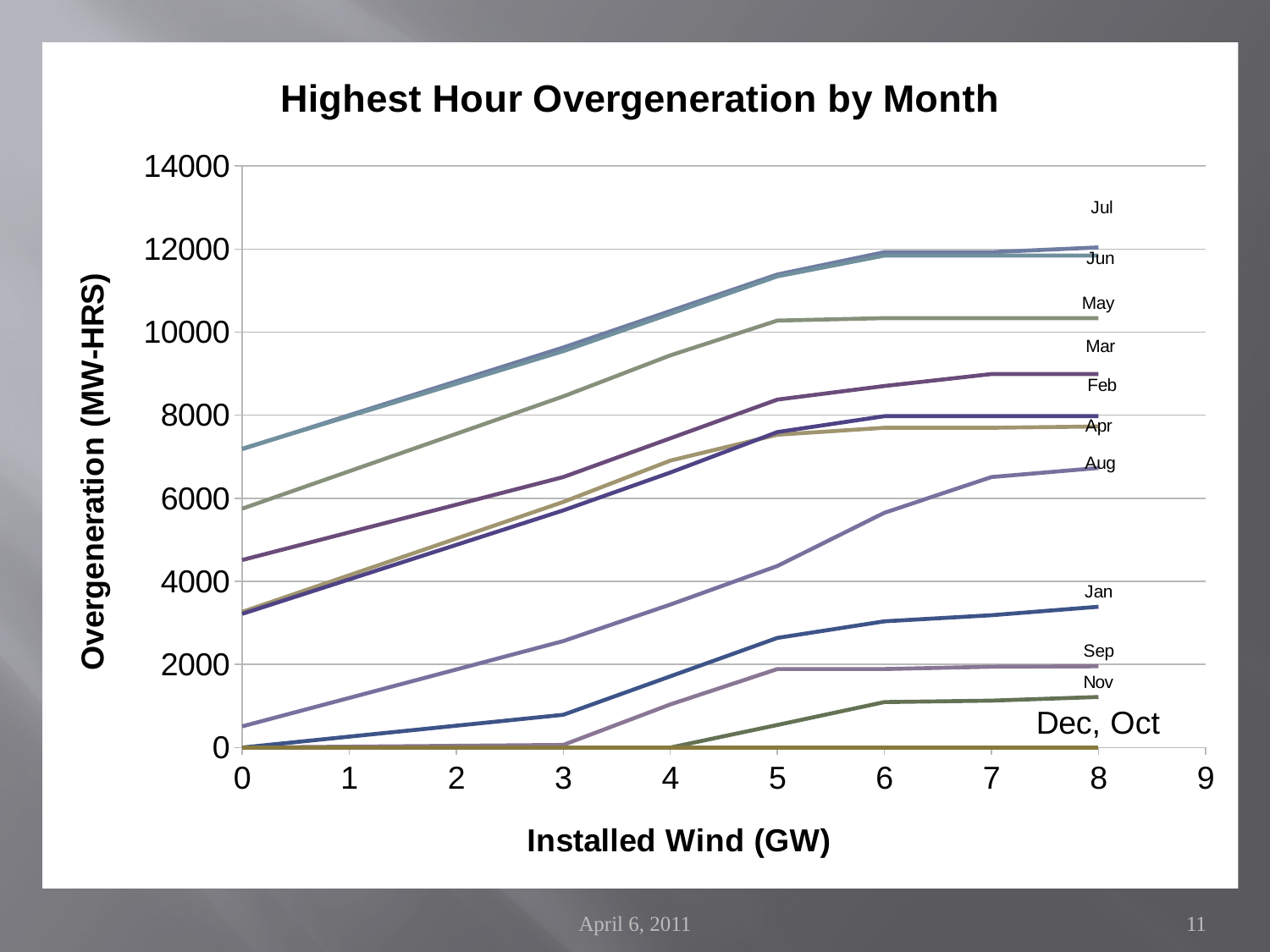
Is the value for Aug at 0 GW installed wind greater or less than 2000? less Is the value for May at 8 GW installed wind greater or less than 10000? greater Does the Jan line rise or fall as installed wind increases? rises What is the title of the chart? Highest Hour Overgeneration by Month What is the label of the x axis? Installed Wind (GW) Is the value for Mar at 8 GW installed wind greater or less than 8000? greater At 8 GW installed wind, which is larger, the value for May or the value for Mar? May How many month series are labelled on the chart? 12 Which months have a value of 0 across the whole range of installed wind? Dec, Oct What kind of chart is shown on the slide? line chart